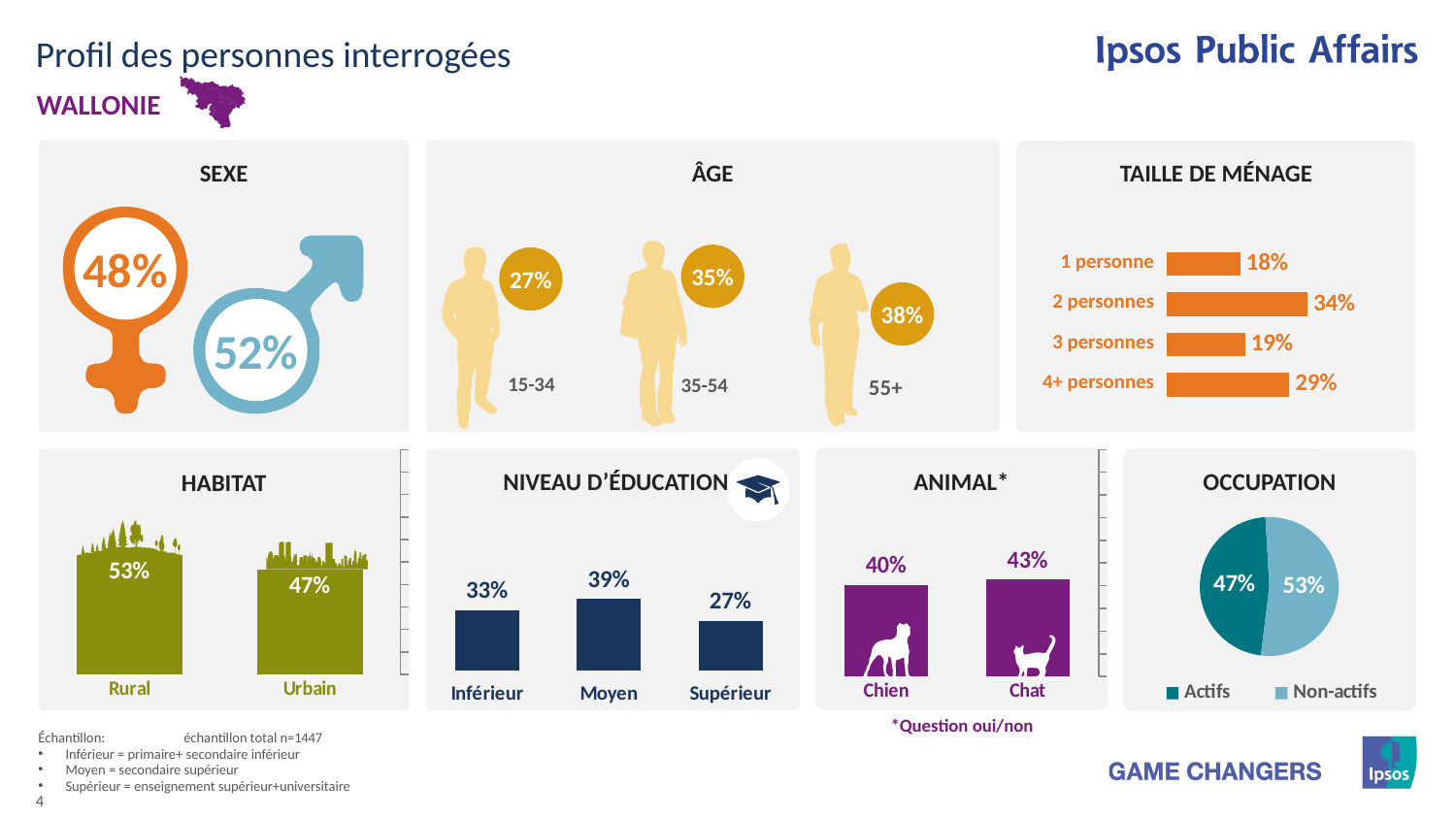
How many series does the legend of the OCCUPATION chart list? 2 In the TAILLE DE MÉNAGE chart, which household size has the lowest value? 1 personne In the TAILLE DE MÉNAGE chart, what is the difference between 4+ personnes and 3 personnes? 10% In the NIVEAU D'ÉDUCATION chart, what is the difference between Inférieur and Supérieur? 6% In the OCCUPATION pie chart, what share is Non-actifs? 53% What kind of chart is used in the OCCUPATION panel? Pie chart In the TAILLE DE MÉNAGE chart, what is the value for 2 personnes? 34% In the HABITAT chart, which is larger, Rural or Urbain? Rural In the NIVEAU D'ÉDUCATION chart, what is the value for Moyen? 39% In the TAILLE DE MÉNAGE chart, how many household-size categories are shown? 4 In the ANIMAL chart, what is the value for Chat? 43% In the NIVEAU D'ÉDUCATION chart, which category has the highest value? Moyen